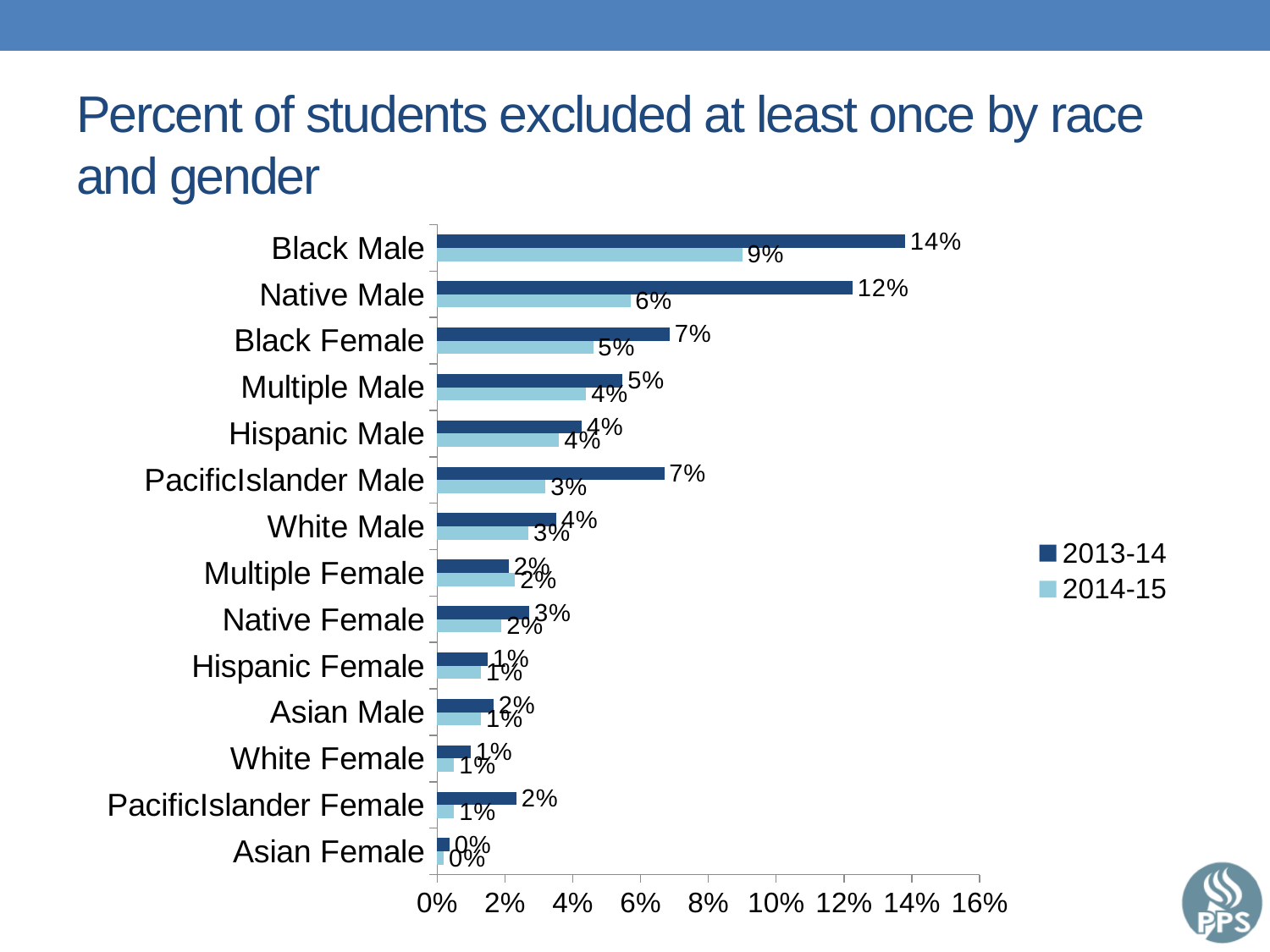
What is the difference between the 2013-14 and 2014-15 values for Black Male? 5% What is the 2014-15 value for Native Male? 6% Which category has the highest 2013-14 value? Black Male Which is larger, the 2013-14 value for PacificIslander Male or the 2013-14 value for Multiple Male? PacificIslander Male Which category has the lowest 2014-15 value? Asian Female What is the 2013-14 value for Black Male? 14% How many race-and-gender categories are shown on the chart? 14 What is the 2014-15 value for PacificIslander Male? 3% What is the difference between the 2013-14 values for Native Male and Black Female? 5% What kind of chart is shown on the slide? Bar chart Is the 2013-14 value for Native Male greater or less than 10%? greater How many series does the legend list? 2